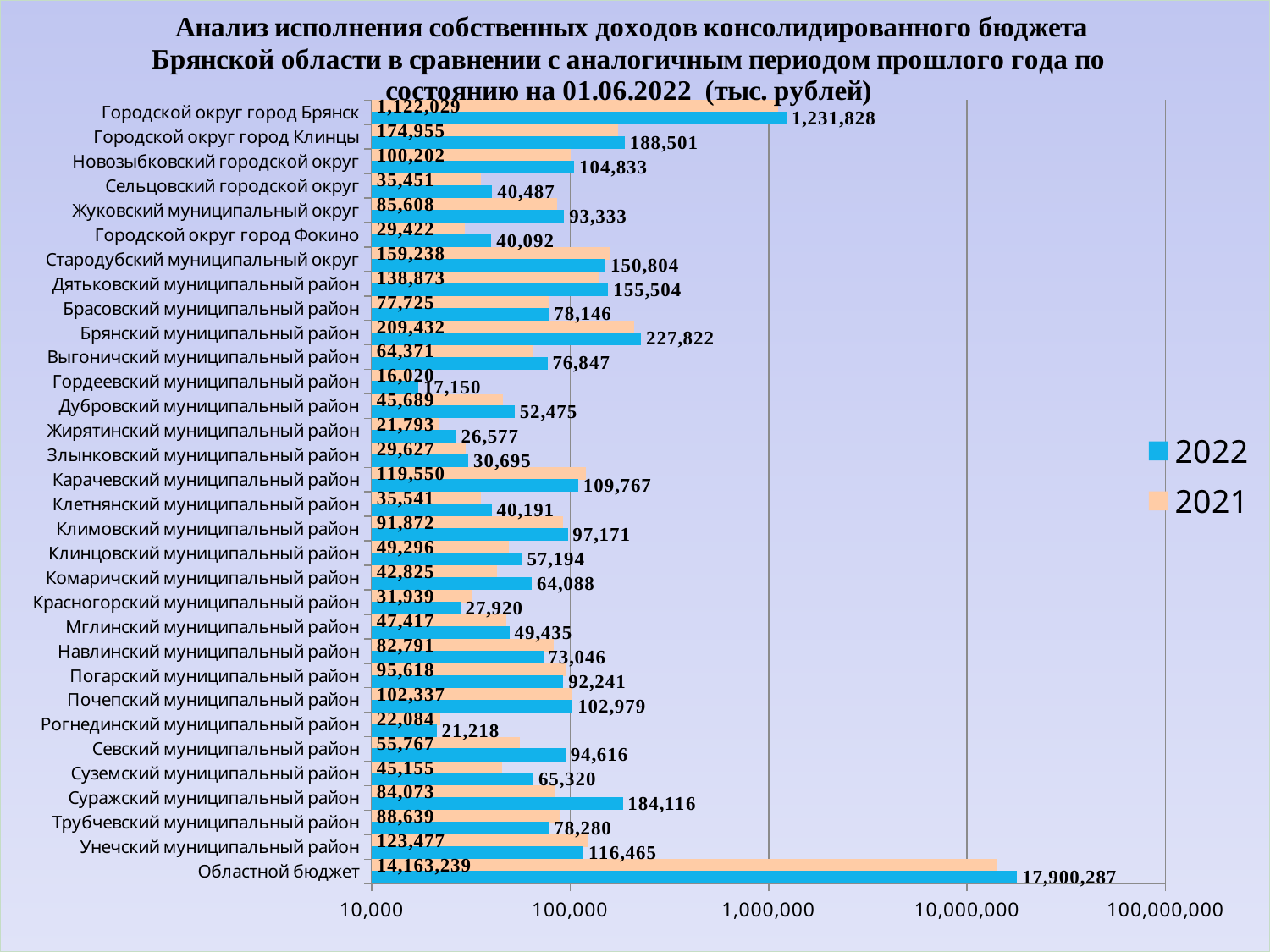
Which category has the lowest 2022 value? Гордеевский муниципальный район Which colour represents the 2022 series in the legend? blue What is the difference between the 2022 and 2021 values for Областной бюджет? 3,737,048 What is the 2021 value for Унечский муниципальный район? 123,477 What is the 2021 value for Городской округ город Брянск? 1,122,029 What is the difference between the 2022 and 2021 values for Брянский муниципальный район? 18,390 How many series does the legend list? 2 What is the 2022 value for Суражский муниципальный район? 184,116 What is the 2022 value for Областной бюджет? 17,900,287 What kind of chart is shown on the slide? bar chart Which category has the highest 2022 value? Областной бюджет For Красногорский муниципальный район, which year has the larger value, 2022 or 2021? 2021